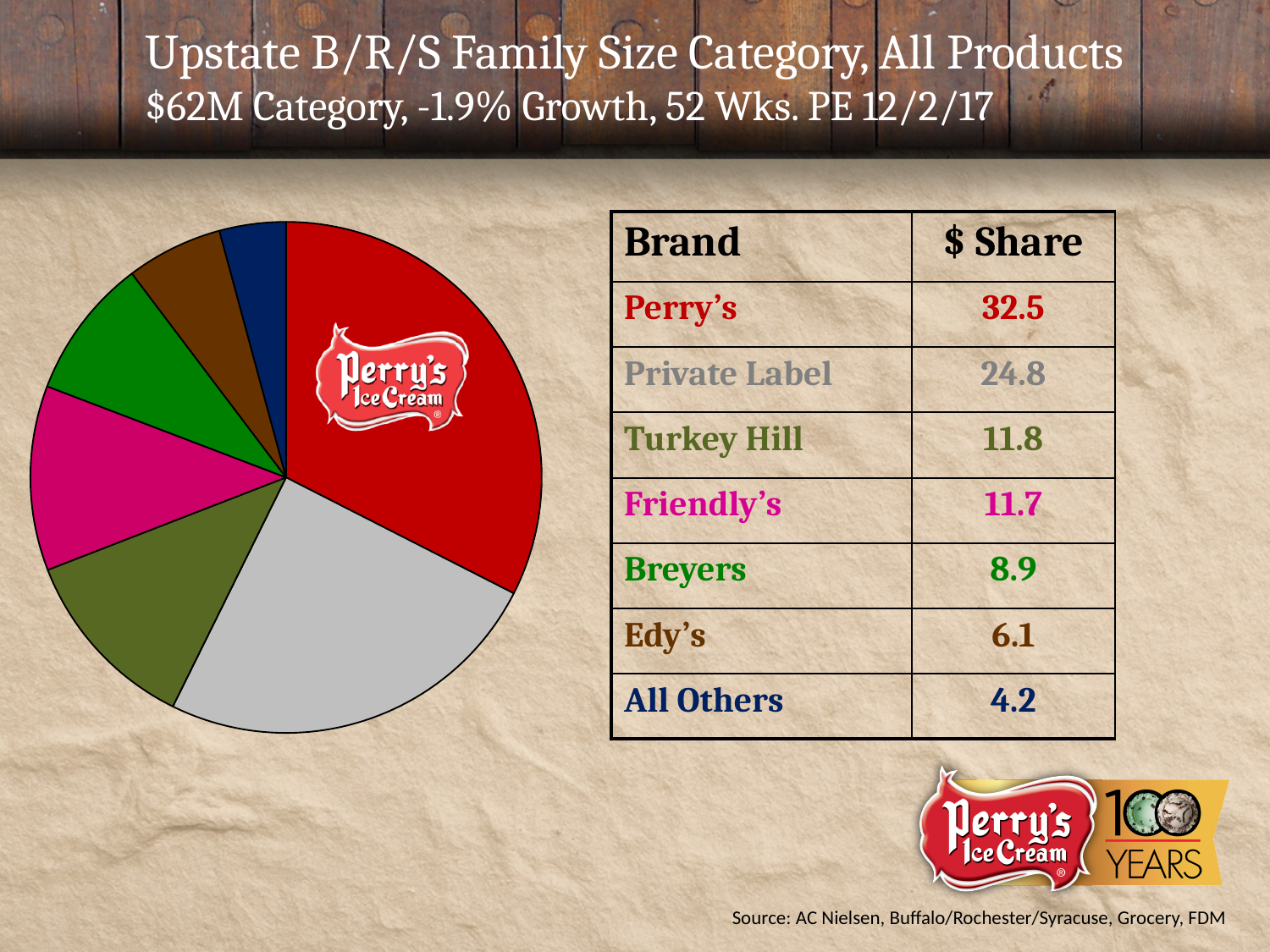
What is the $ share for Private Label? 24.8 What is the difference in $ share between Perry's and Private Label? 7.7 Which brand is represented by the red slice of the pie chart? Perry's Which brand has the smallest $ share in the pie chart? All Others What is the $ share for Perry's? 32.5 How many slices does the pie chart have? 7 What is the $ share for Edy's? 6.1 Which brand has the largest $ share in the pie chart? Perry's What kind of chart is shown on the slide? pie chart What is the title of the slide containing the pie chart? Upstate B/R/S Family Size Category, All Products Which has a larger $ share, Breyers or Edy's? Breyers What is the $ share for Breyers? 8.9